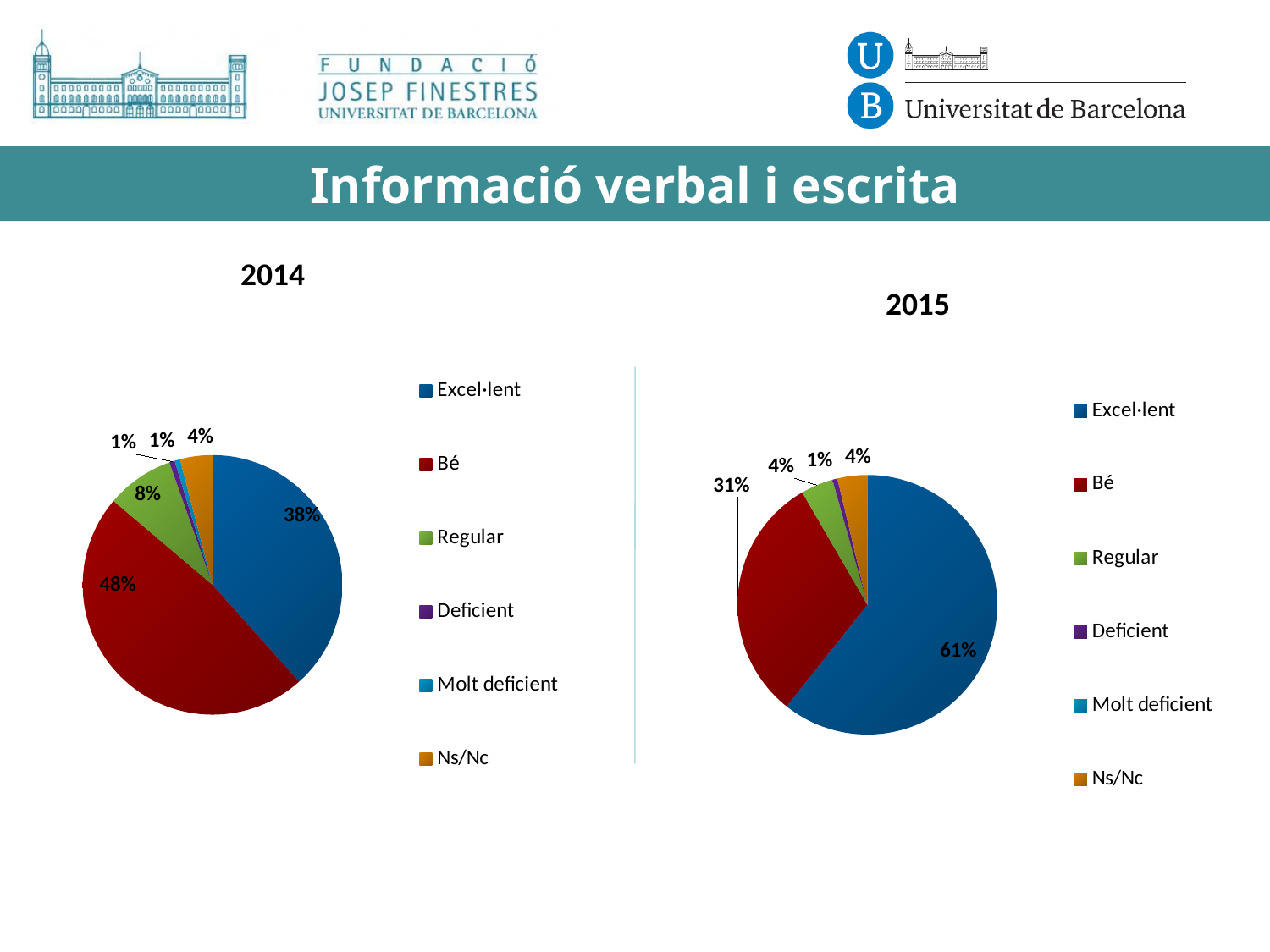
In the 2014 pie chart, what share does Excel·lent have? 38% In the 2015 pie chart, what share does Bé have? 31% In the 2014 pie chart, which category has the largest slice? Bé In the 2014 pie chart, which is larger, the Bé slice or the Excel·lent slice? Bé How many entries does the legend of the 2015 pie chart list? 6 In the 2014 pie chart, what share does Regular have? 8% In the 2015 pie chart, what share does Regular have? 4% In the 2015 pie chart, which category has the largest slice? Excel·lent What type of chart is used for the 2014 data? Pie chart What is the difference between the Excel·lent share in 2015 and the Excel·lent share in 2014? 23 percentage points In the 2014 pie chart, what share does Bé have? 48% In the 2015 pie chart, what share does Excel·lent have? 61%